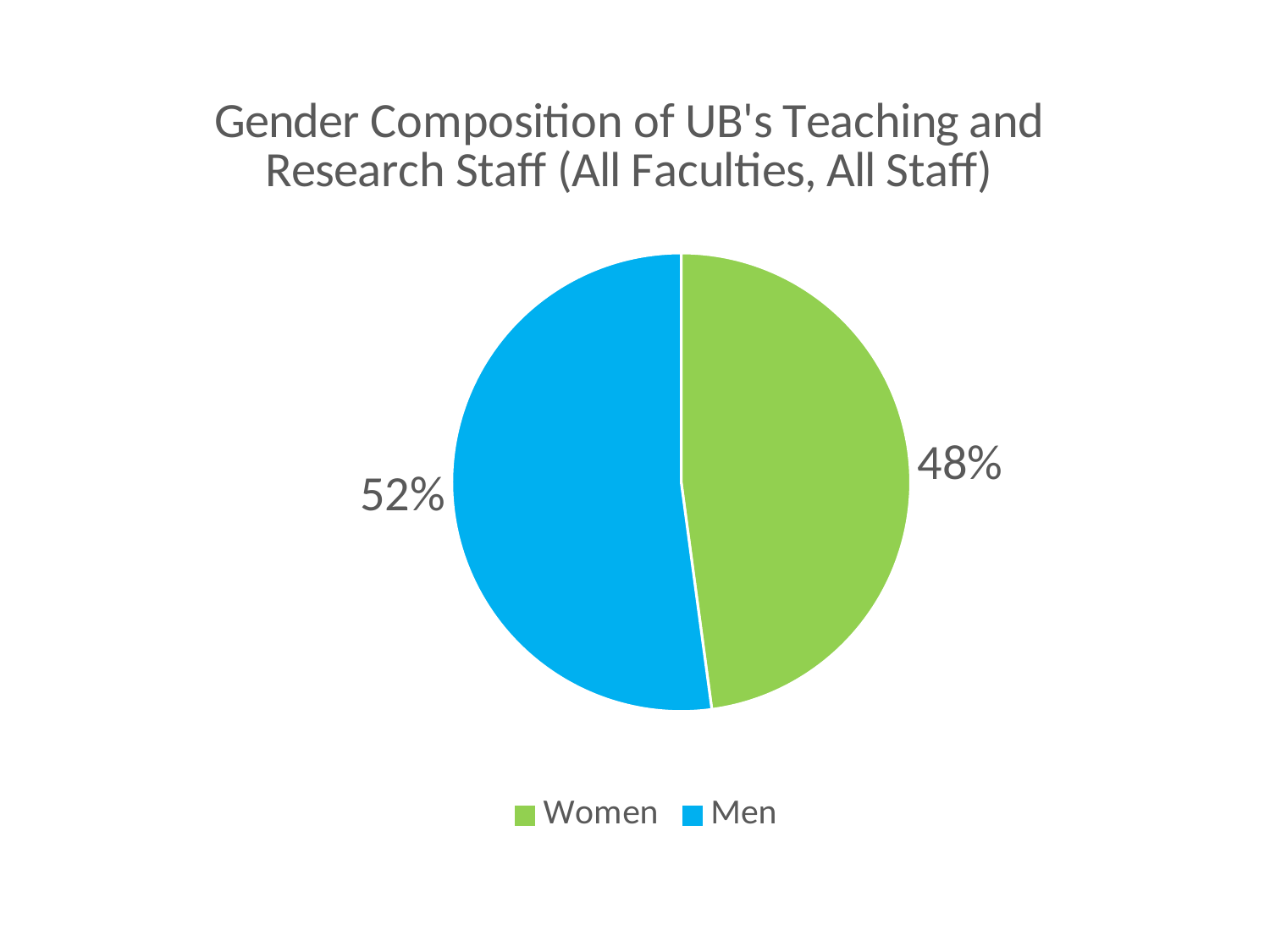
What kind of chart is shown on the slide? Pie chart Is the share for Women larger or smaller than the share for Men? smaller Which group has the smaller share of the pie? Women How many slices does the pie chart have? 2 What share of UB's teaching and research staff are women? 48% Which colour represents Women in the chart? Green Which group has the larger share of the pie, Women or Men? Men Is the share for Men greater or less than 50%? greater What is the difference in percentage points between the Men and Women shares? 4 percentage points What is the title of the chart? Gender Composition of UB's Teaching and Research Staff (All Faculties, All Staff) How many entries does the legend list? 2 What share of UB's teaching and research staff are men? 52%